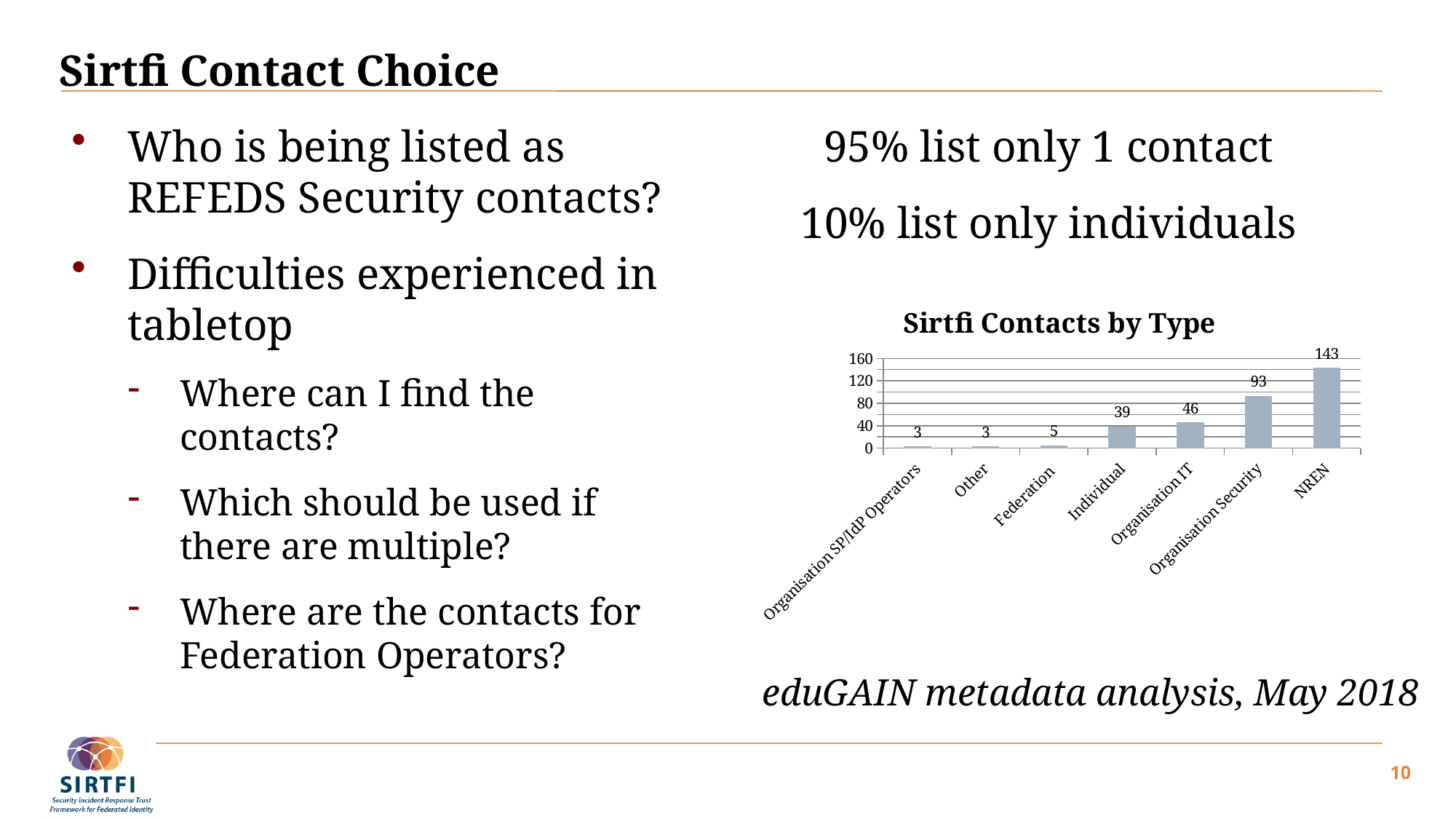
What is the value for Federation in the Sirtfi Contacts by Type chart? 5 How many categories are shown in the Sirtfi Contacts by Type chart? 7 Which is larger in the Sirtfi Contacts by Type chart, Organisation IT or Individual? Organisation IT What is the value for Organisation Security in the Sirtfi Contacts by Type chart? 93 Is the value for Organisation Security greater or less than 80 in the Sirtfi Contacts by Type chart? greater What kind of chart is the Sirtfi Contacts by Type chart? Bar chart What is the title of the chart on the slide? Sirtfi Contacts by Type What is the value for NREN in the Sirtfi Contacts by Type chart? 143 What is the value for Individual in the Sirtfi Contacts by Type chart? 39 Do the values in the Sirtfi Contacts by Type chart generally rise or fall from left to right? Rise Which category has the highest value in the Sirtfi Contacts by Type chart? NREN What is the difference between the values for NREN and Organisation Security in the Sirtfi Contacts by Type chart? 50